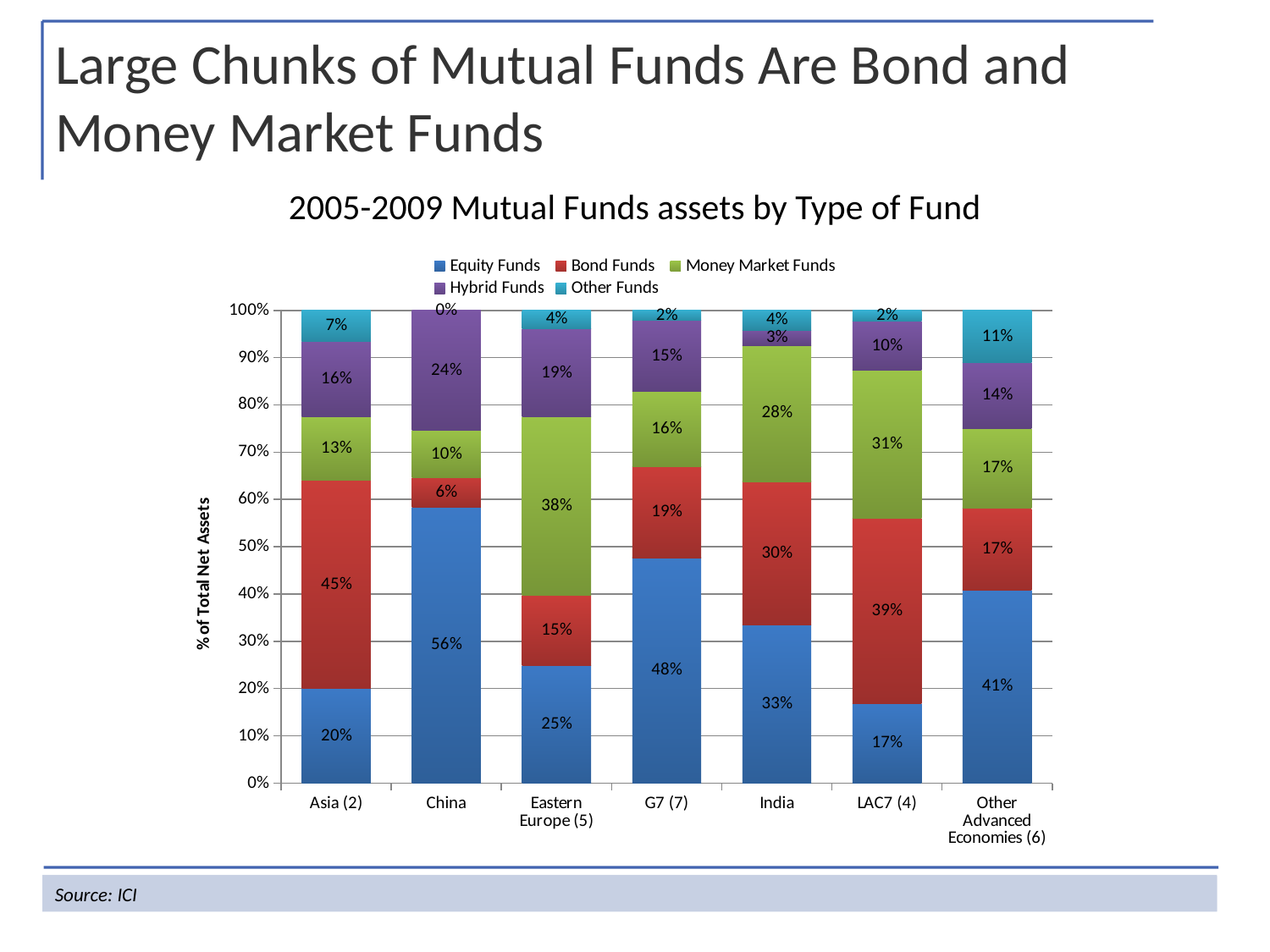
What is the difference between the Bond Funds share and the Equity Funds share for Asia (2)? 25 percentage points How many categories are shown on the x axis? 7 How many series does the legend list? 5 Which category has the lowest Equity Funds share? LAC7 (4) Which is larger for India: the Bond Funds share or the Money Market Funds share? Bond Funds What is the Other Funds share for Other Advanced Economies (6)? 11% What percentage of total net assets do Equity Funds represent for China? 56% What is the Money Market Funds share for Eastern Europe (5)? 38% What is the Bond Funds share for Asia (2)? 45% What kind of chart is shown on the slide? Stacked bar chart Which category has the highest Equity Funds share? China What is the title of the chart? 2005-2009 Mutual Funds assets by Type of Fund